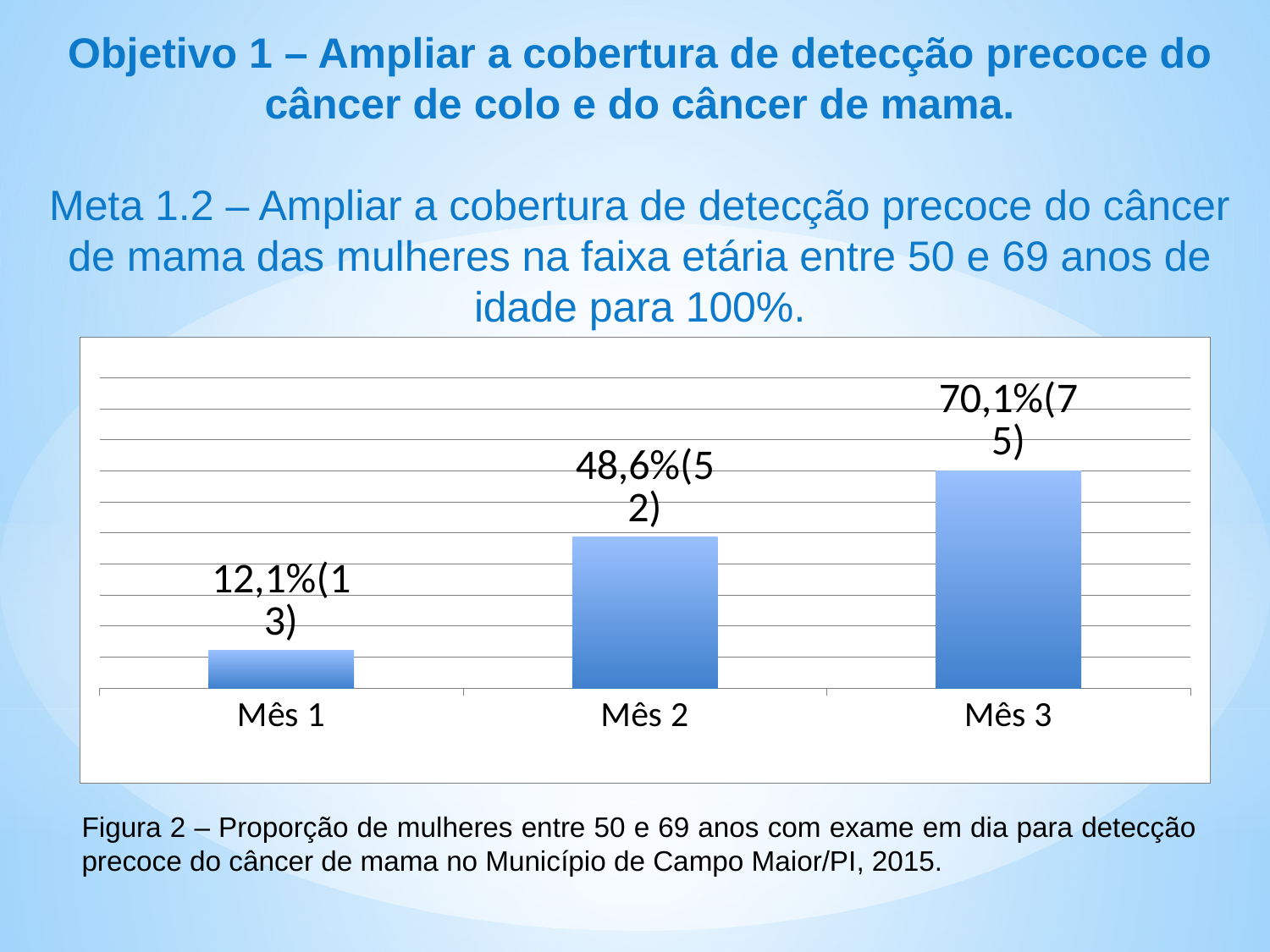
Which month has the highest value? Mês 3 What is the difference in percentage points between Mês 3 and Mês 1? 58,0 What percentage is shown for Mês 1? 12,1% What kind of chart is this? Bar chart What percentage is shown for Mês 2? 48,6% How many months are shown on the x axis? 3 Which is larger, the value for Mês 2 or the value for Mês 3? Mês 3 Which month has the lowest value? Mês 1 What number of women is shown in parentheses for Mês 1? 13 What number of women is shown in parentheses for Mês 3? 75 What is the difference in percentage points between Mês 2 and Mês 1? 36,5 What percentage is shown for Mês 3? 70,1%